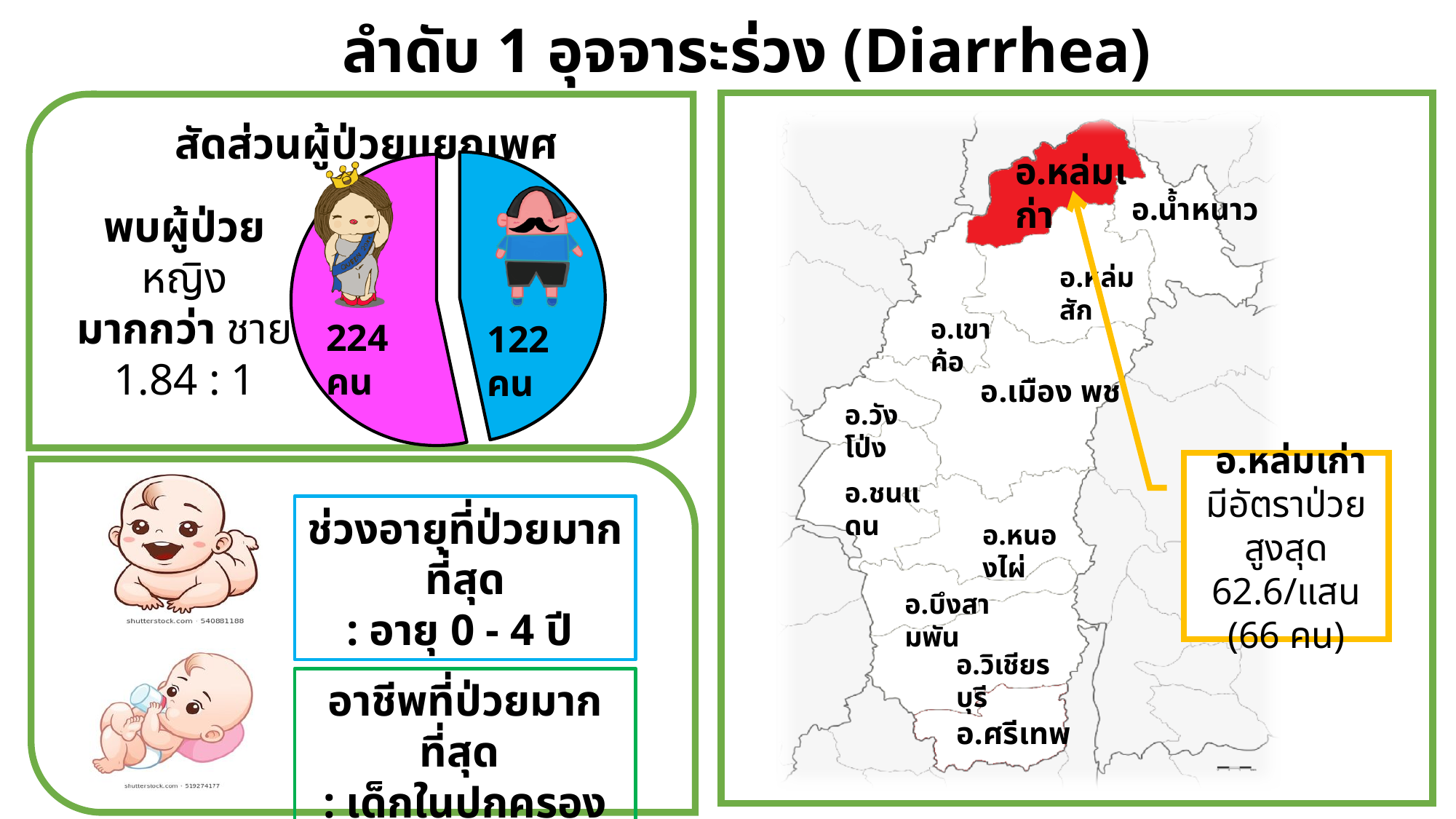
How many slices does the pie chart สัดส่วนผู้ป่วยแยกเพศ have? 2 In the pie chart สัดส่วนผู้ป่วยแยกเพศ, what share of all patients is female? 64.7% In the pie chart สัดส่วนผู้ป่วยแยกเพศ, what colour is the slice for male patients? blue According to the text next to the pie chart, what is the female-to-male ratio of patients? 1.84 : 1 In the pie chart สัดส่วนผู้ป่วยแยกเพศ, how many patients are female (หญิง)? 224 คน In the pie chart สัดส่วนผู้ป่วยแยกเพศ, how many patients are male (ชาย)? 122 คน In the pie chart สัดส่วนผู้ป่วยแยกเพศ, what colour is the slice for female patients? pink In the pie chart สัดส่วนผู้ป่วยแยกเพศ, what is the difference between the number of female and male patients? 102 คน What kind of chart is shown in the top-left panel titled สัดส่วนผู้ป่วยแยกเพศ? pie chart In the pie chart สัดส่วนผู้ป่วยแยกเพศ, which group has the smallest slice? male (ชาย) In the pie chart สัดส่วนผู้ป่วยแยกเพศ, which group has the larger slice, female or male? female (หญิง) In the pie chart สัดส่วนผู้ป่วยแยกเพศ, what is the total number of patients across both slices? 346 คน